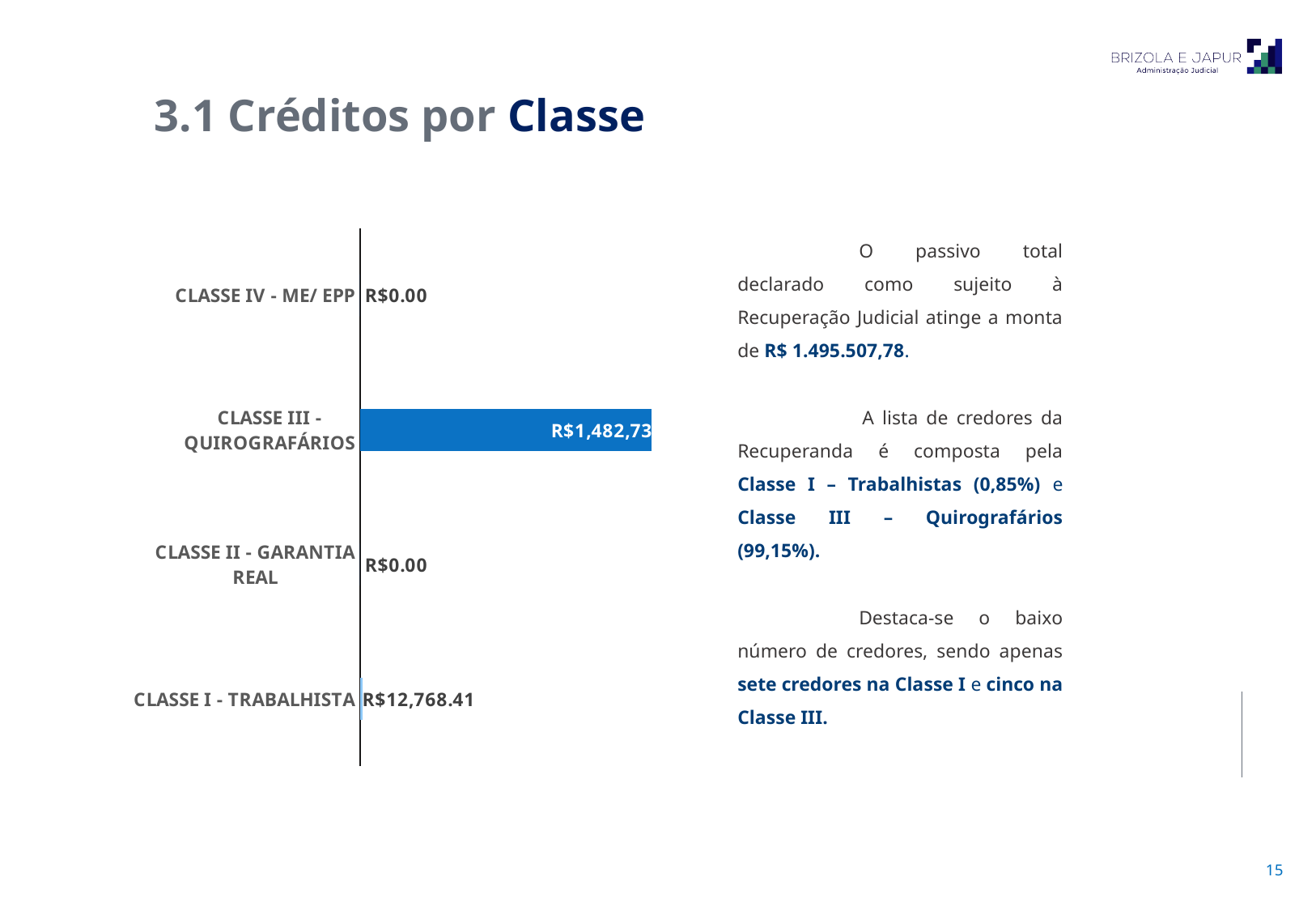
What colour is the bar for CLASSE III - QUIROGRAFÁRIOS? blue What is the title of the slide containing the chart? 3.1 Créditos por Classe What kind of chart is shown on the slide? bar chart Which class has the highest value in the chart? CLASSE III - QUIROGRAFÁRIOS What is the value shown for CLASSE IV - ME/ EPP? R$0.00 How many classes in the chart have a value of R$0.00? 2 What is the value shown for CLASSE I - TRABALHISTA? R$12,768.41 Which is larger, the value for CLASSE I - TRABALHISTA or the value for CLASSE IV - ME/ EPP? CLASSE I - TRABALHISTA Which is larger, the value for CLASSE III - QUIROGRAFÁRIOS or the value for CLASSE I - TRABALHISTA? CLASSE III - QUIROGRAFÁRIOS What is the value shown for CLASSE II - GARANTIA REAL? R$0.00 What is the difference between the values for CLASSE I - TRABALHISTA and CLASSE II - GARANTIA REAL? R$12,768.41 How many classes (categories) are plotted in the chart? 4